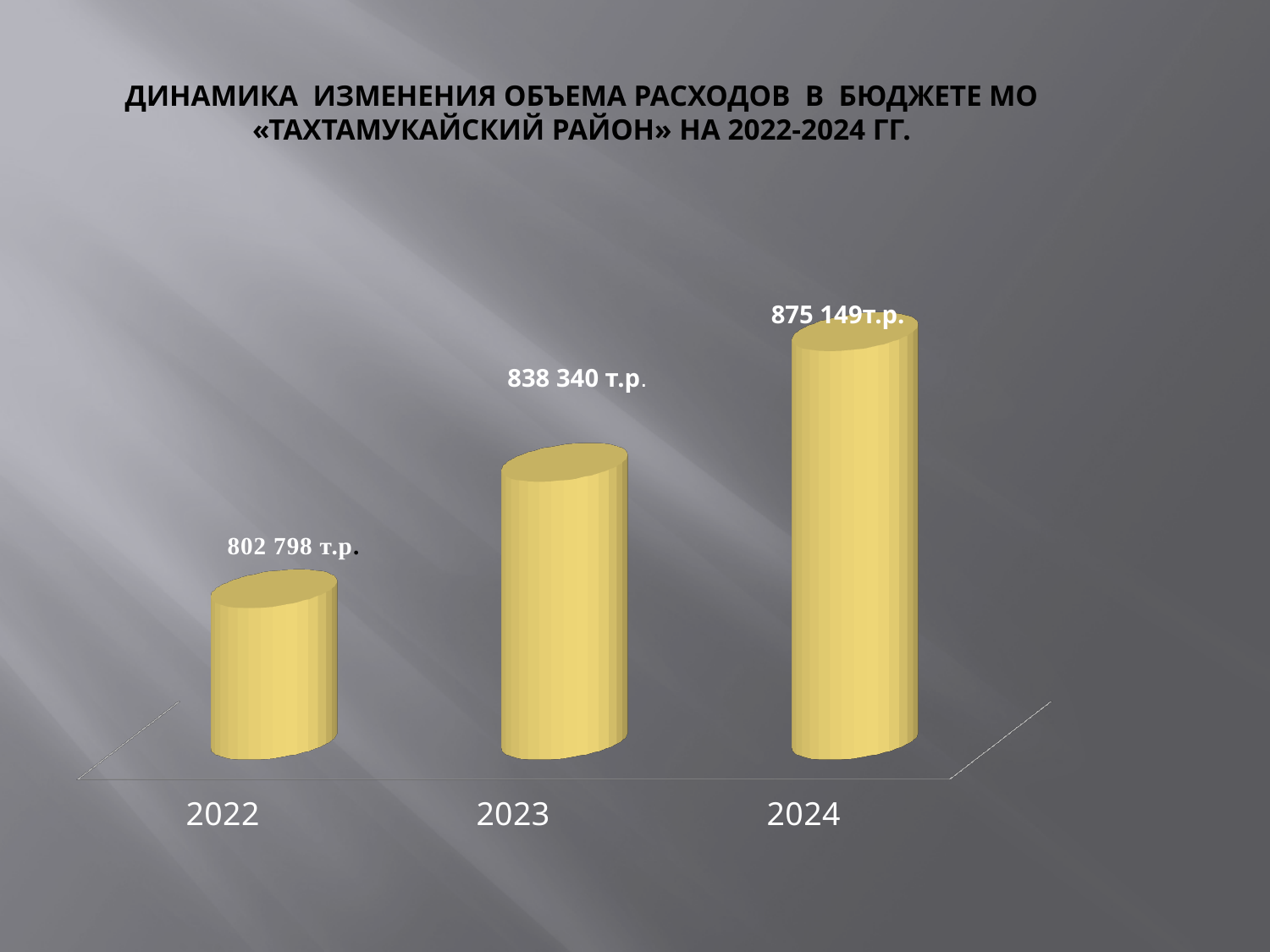
What is the value shown for 2023? 838 340 т.р. What is the difference between the values for 2023 and 2022? 35 542 т.р. Do the values rise or fall from 2022 to 2024? Rise What is the difference between the values for 2024 and 2022? 72 351 т.р. How many years are shown on the chart? 3 What kind of chart is shown on the slide? Bar chart Which year has the lowest value? 2022 Which year has the highest value? 2024 What is the value shown for 2022? 802 798 т.р. Which is larger, the value for 2023 or the value for 2024? 2024 What is the value shown for 2024? 875 149 т.р. What is the difference between the values for 2024 and 2023? 36 809 т.р.